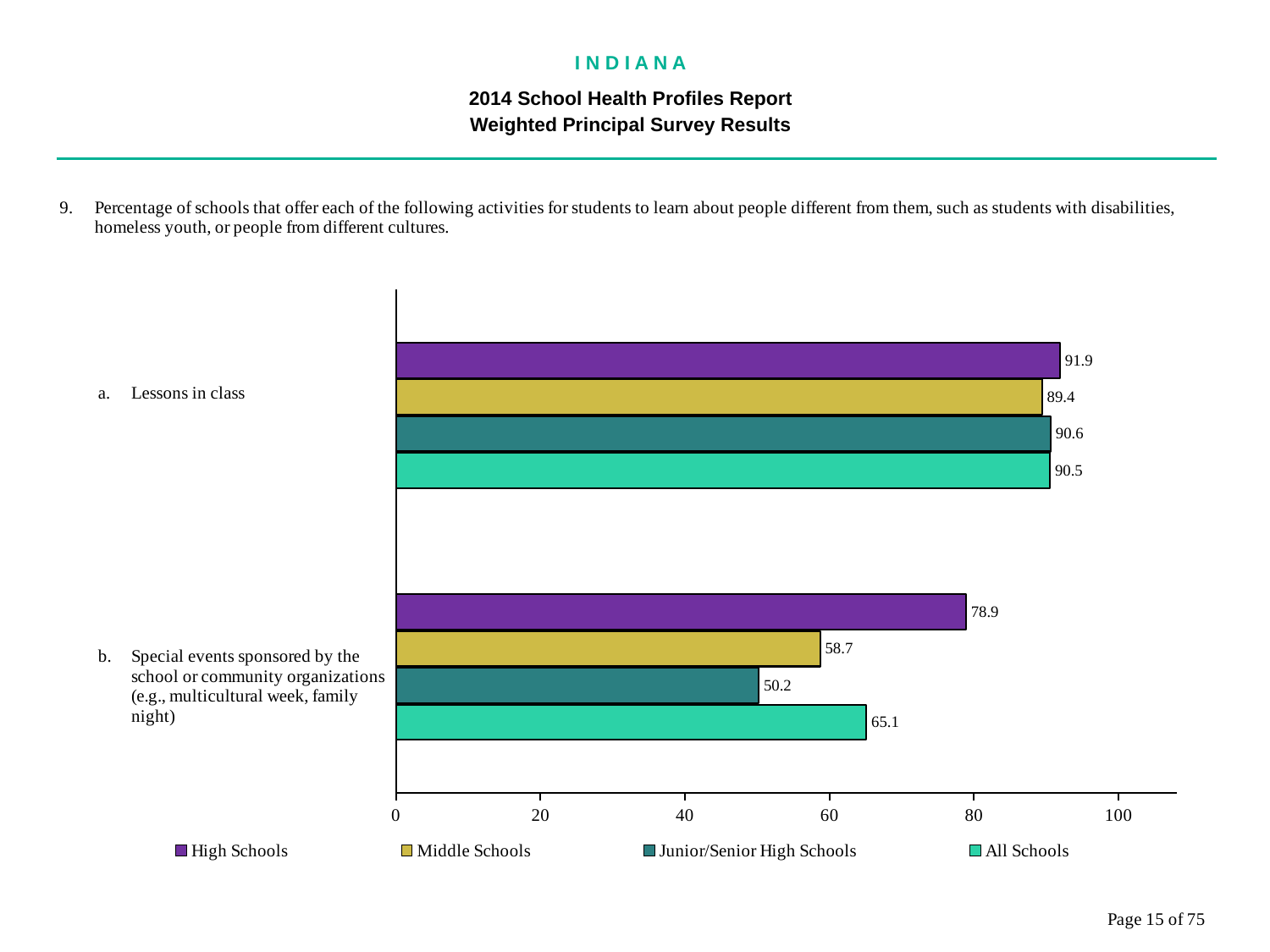
What is the value for High Schools for "Lessons in class"? 91.9 Which is larger for Middle Schools: the value for "Lessons in class" or the value for "Special events sponsored by the school or community organizations"? Lessons in class Which school type has the highest value for "Special events sponsored by the school or community organizations"? High Schools What is the difference between the High Schools value for "Lessons in class" and the High Schools value for "Special events sponsored by the school or community organizations"? 13 Is the value for All Schools for "Special events sponsored by the school or community organizations" greater or less than 60? greater What is the value for All Schools for "Special events sponsored by the school or community organizations"? 65.1 What is the value for Junior/Senior High Schools for "Special events sponsored by the school or community organizations"? 50.2 How many series does the legend list? 4 What is the difference between the High Schools value and the Middle Schools value for "Special events sponsored by the school or community organizations"? 20.2 What kind of chart is shown on the slide? Bar chart Which school type has the lowest value for "Lessons in class"? Middle Schools Which school type has the lowest value for "Special events sponsored by the school or community organizations"? Junior/Senior High Schools